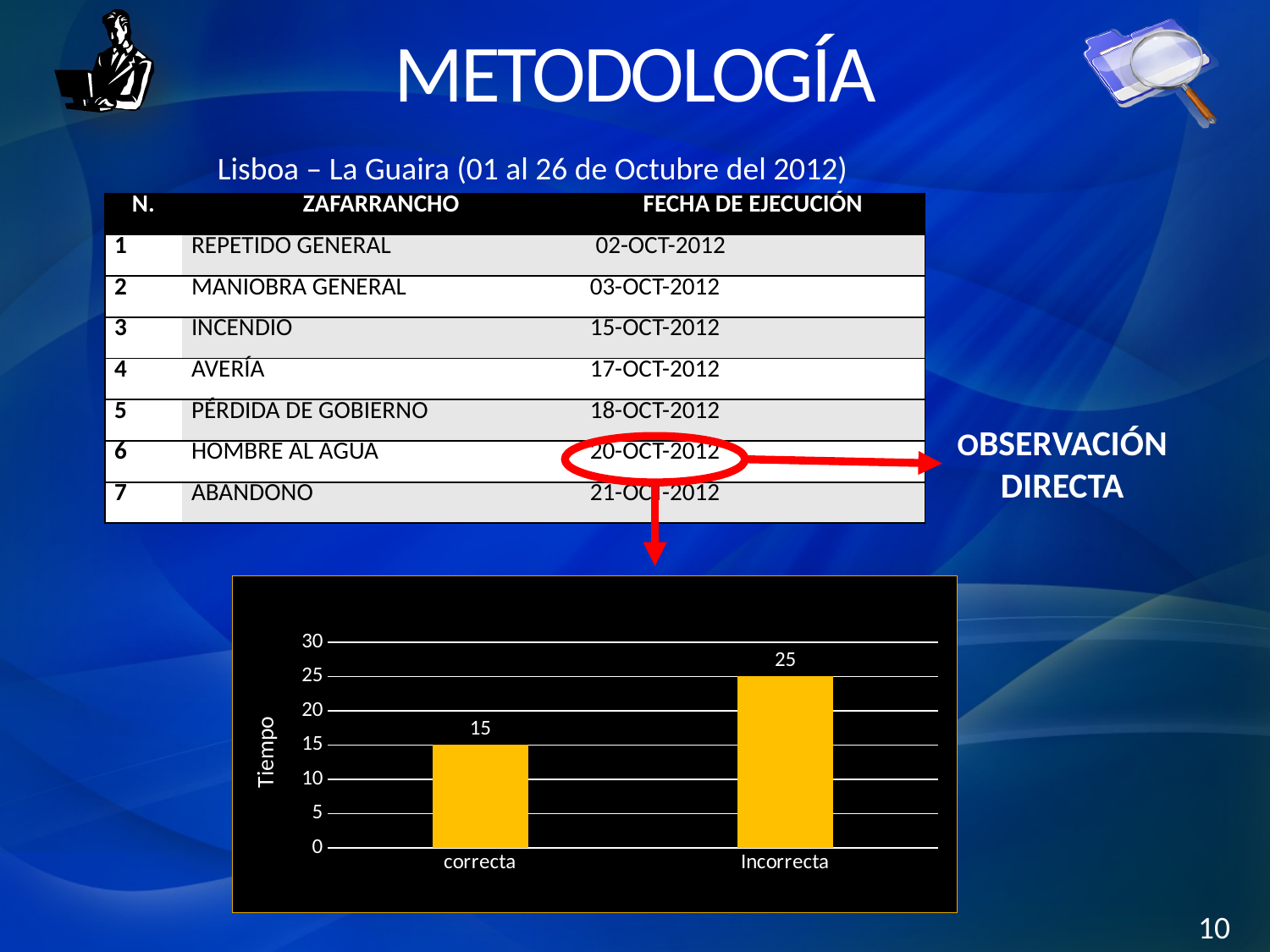
What is the value for 'correcta' in the bar chart? 15 Which category has the highest value in the bar chart? Incorrecta What is the maximum value shown on the vertical axis of the bar chart? 30 How many categories are shown in the bar chart? 2 What is the value for 'Incorrecta' in the bar chart? 25 Is the value for 'Incorrecta' greater or less than 20? greater What is the difference between the values for 'Incorrecta' and 'correcta' in the bar chart? 10 Which category has the lowest value in the bar chart? correcta What is the label of the vertical axis of the bar chart? Tiempo Which is larger in the bar chart, the value for 'correcta' or for 'Incorrecta'? Incorrecta What kind of chart is shown on the slide? bar chart